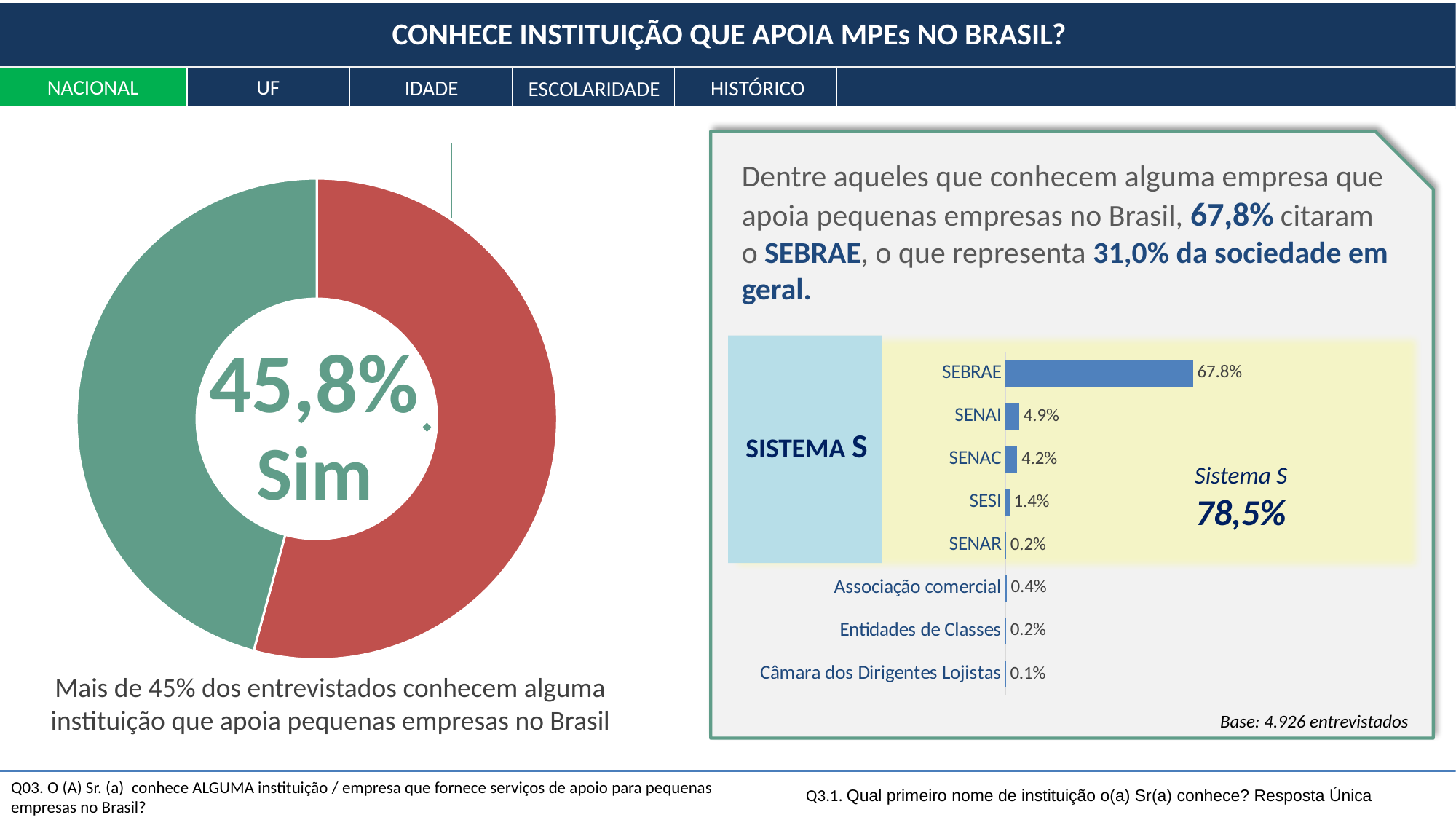
In the bar chart on the right, what is the value for SEBRAE? 67.8% In the bar chart on the right, what is the difference between the values for SEBRAE and SENAI? 62.9% In the bar chart on the right, what is the value for SESI? 1.4% In the bar chart on the right, which institution has the highest value? SEBRAE In the bar chart on the right, what is the value for SENAI? 4.9% In the bar chart on the right, which is larger, the value for SENAI or the value for SENAC? SENAI In the bar chart on the right, which institution has the lowest value? Câmara dos Dirigentes Lojistas What kind of chart is shown on the left side of the slide? Pie (donut) chart In the donut chart on the left, what share is labelled 'Sim'? 45,8% In the bar chart on the right, what is the value for Associação comercial? 0.4% What kind of chart is shown on the right side of the slide? Bar chart How many institutions are listed in the bar chart on the right? 8